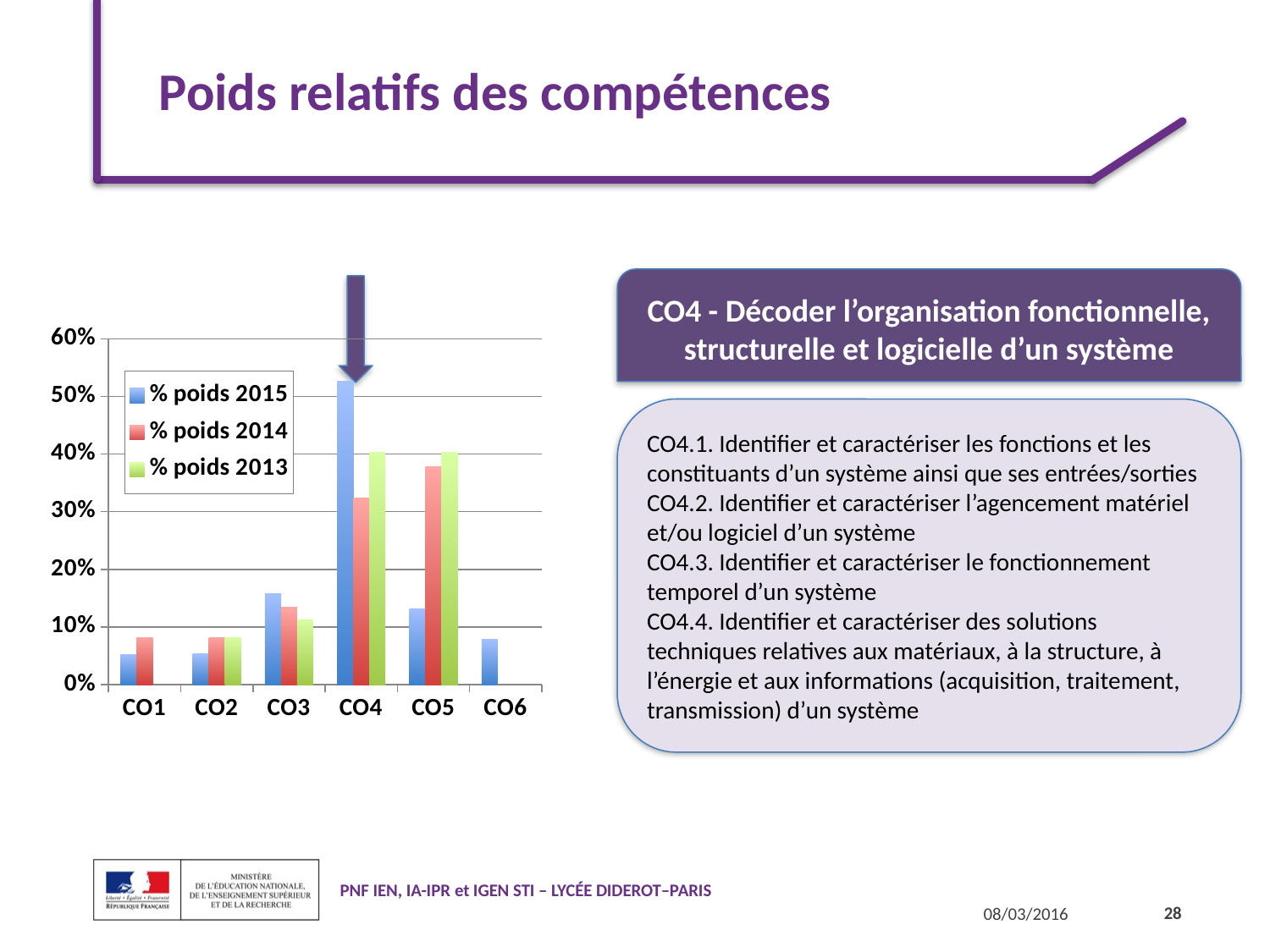
Is the value for CO1 in the % poids 2015 series greater or less than 10%? less For CO4, which series has the larger value: % poids 2015 or % poids 2013? % poids 2015 Which category has the highest value for the % poids 2015 series? CO4 How many categories are shown on the x axis of the chart? 6 Is the value for CO4 in the % poids 2014 series greater or less than 40%? less Which category has the highest value for the % poids 2014 series? CO5 Is the value for CO4 in the % poids 2015 series greater or less than 50%? greater How many series does the chart legend list? 3 For CO5, which series has the larger value: % poids 2015 or % poids 2014? % poids 2014 Which series is shown in blue in the chart legend? % poids 2015 What kind of chart is shown on the slide? bar chart